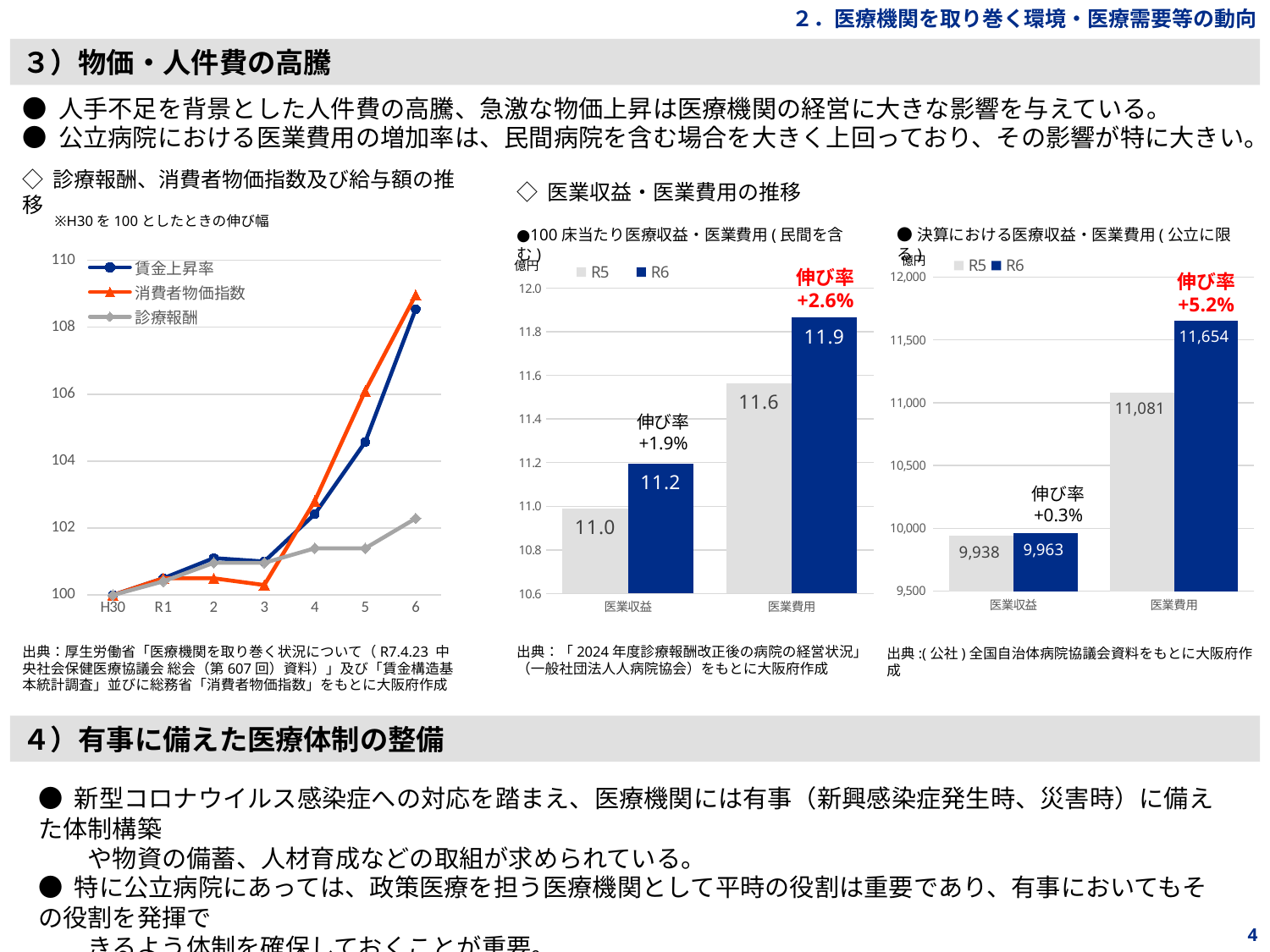
In the right chart (決算における医療収益・医業費用), what is the R6 value for 医業費用? 11,654 What kind of chart is the middle chart (100床当たり医療収益・医業費用)? bar chart In the right chart (決算における医療収益・医業費用), what is the difference between the R6 and R5 values for 医業費用? 573 In the right chart (決算における医療収益・医業費用), what is the R5 value for 医業収益? 9,938 In the left line chart, does the 賃金上昇率 series rise or fall from year 3 to year 6? rise In the right chart (決算における医療収益・医業費用), which bar has the highest value? R6 医業費用 In the middle chart (100床当たり医療収益・医業費用), what is the R6 value for 医業費用? 11.9 In the middle chart (100床当たり医療収益・医業費用), what is the R5 value for 医業収益? 11.0 In the middle chart (100床当たり医療収益・医業費用), what is the difference between the R6 and R5 values for 医業収益? 0.2 How many series does the legend of the left line chart list? 3 In the left line chart, is the value of 消費者物価指数 at year 6 greater or less than 108? greater In the right chart (決算における医療収益・医業費用), which is larger, the R6 value for 医業収益 or the R6 value for 医業費用? 医業費用